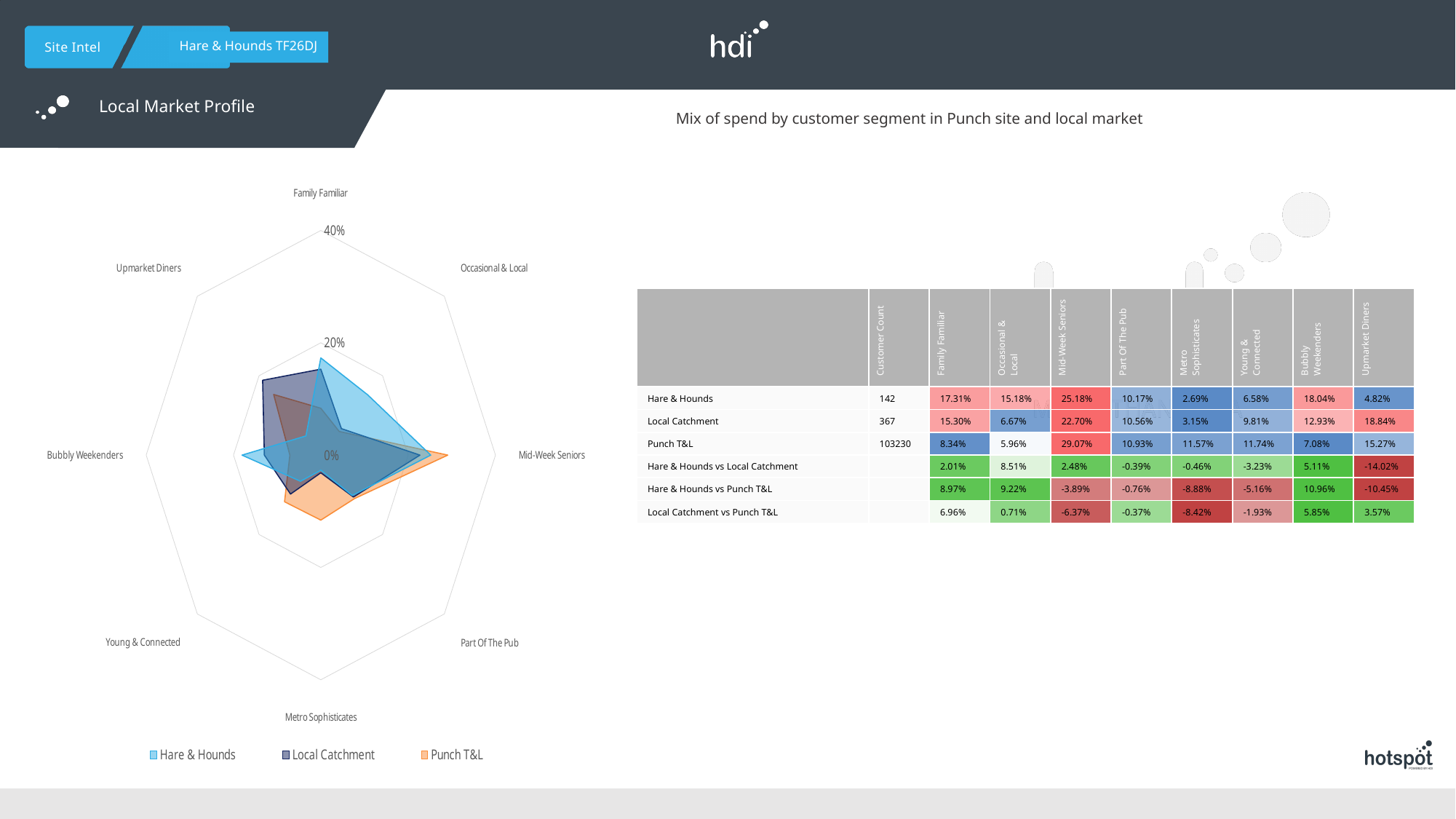
How many customer segments are plotted around the radar chart? 8 What is the Hare & Hounds share of spend for Mid-Week Seniors? 25.18% Which series are listed in the radar chart's legend? Hare & Hounds, Local Catchment, Punch T&L For the Hare & Hounds series, which customer segment has the lowest share of spend? Metro Sophisticates For the Hare & Hounds series, which customer segment has the highest share of spend? Mid-Week Seniors What is the difference between Hare & Hounds and Local Catchment for Family Familiar? 2.01% What is the customer count for Local Catchment in the table? 367 What kind of chart is shown on the left of the slide? Radar chart Is the Punch T&L value for Mid-Week Seniors greater or less than 20%? greater What is the Punch T&L share of spend for Metro Sophisticates? 11.57% For Family Familiar, which is larger: the Hare & Hounds value or the Punch T&L value? Hare & Hounds How many series does the radar chart's legend list? 3